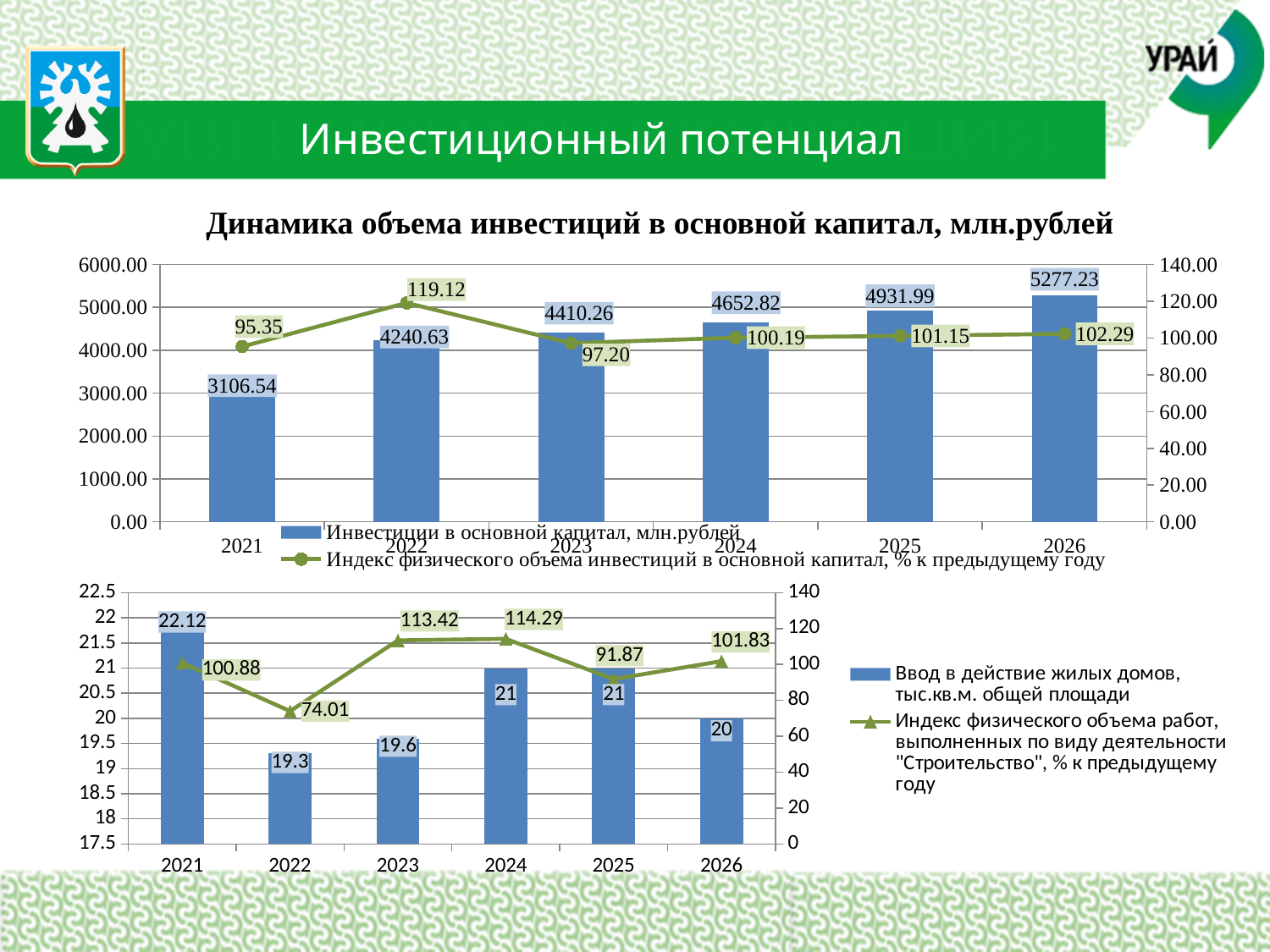
In the bottom chart, how many years are shown on the x axis? 6 In the top chart 'Динамика объема инвестиций в основной капитал, млн.рублей', what is the difference between the investment volumes for 2026 and 2025? 345.24 In the top chart 'Динамика объема инвестиций в основной капитал, млн.рублей', how many series does the legend list? 2 In the bottom chart, what is the index of physical volume of construction works for 2024? 114.29 In the bottom chart, what is the value of housing commissioned (Ввод в действие жилых домов) for 2022? 19.3 In the top chart 'Динамика объема инвестиций в основной капитал, млн.рублей', do the investment bars rise or fall from 2021 to 2026? rise In the top chart 'Динамика объема инвестиций в основной капитал, млн.рублей', which year has the lowest index of physical volume of investments? 2021 In the top chart 'Динамика объема инвестиций в основной капитал, млн.рублей', what is the value of investments in fixed capital for 2021? 3106.54 In the top chart 'Динамика объема инвестиций в основной капитал, млн.рублей', which year has the highest investment volume? 2026 In the bottom chart, which is larger: the housing commissioned in 2021 or in 2026? 2021 In the bottom chart, which year has the lowest index of physical volume of construction works? 2022 In the top chart 'Динамика объема инвестиций в основной капитал, млн.рублей', what is the index of physical volume of investments for 2022? 119.12